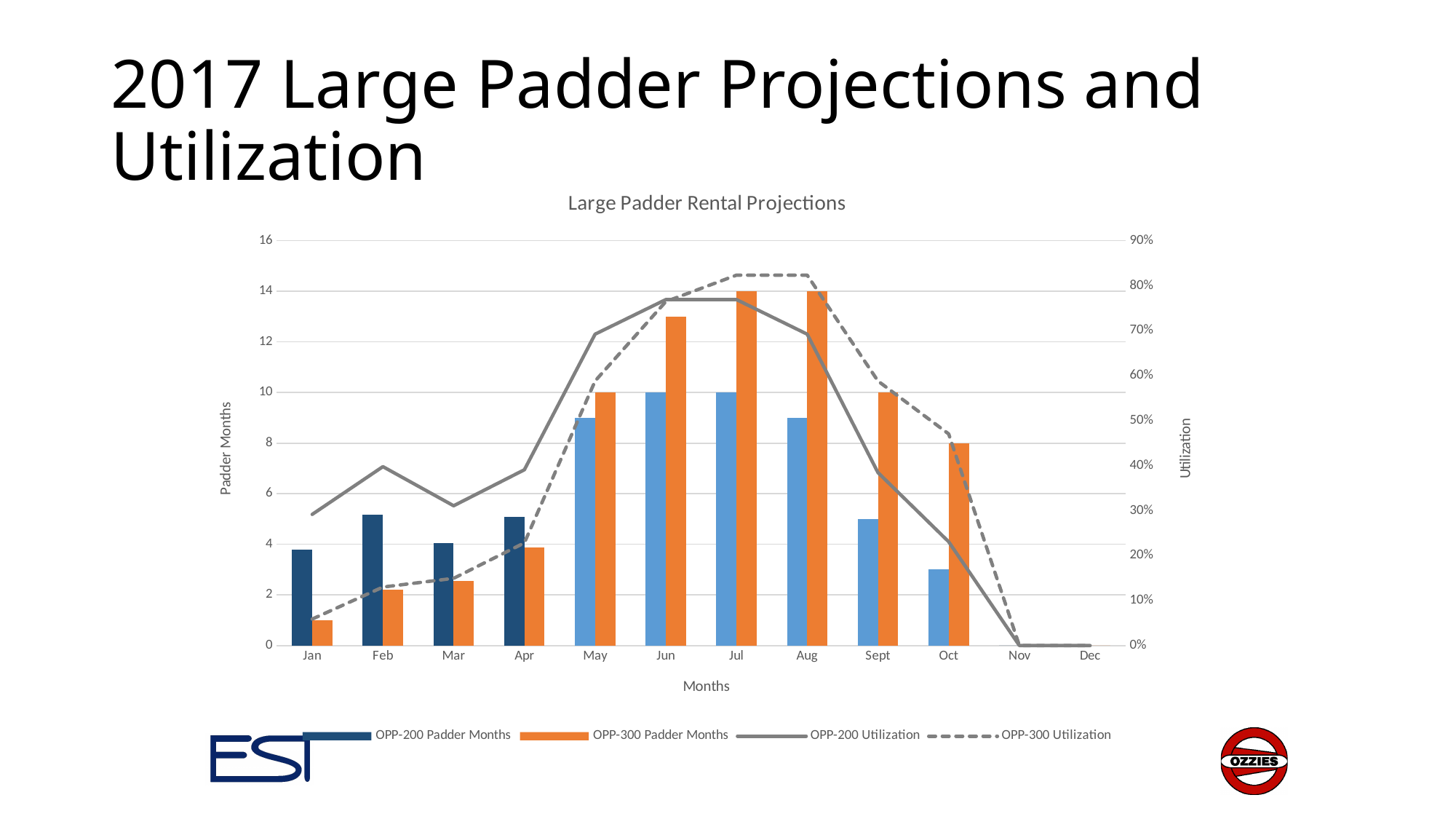
How many series does the chart legend list? 4 What is the OPP-300 Padder Months value for Oct? 8 In Feb, which is larger: OPP-200 Padder Months or OPP-300 Padder Months? OPP-200 Padder Months What is the difference between the OPP-300 Padder Months and OPP-200 Padder Months values in Jul? 4 What kind of chart is shown on the slide? Combination bar and line chart What is the title of the chart? Large Padder Rental Projections What is the OPP-300 Padder Months value for Jul? 14 Is the OPP-200 Utilization value for Jul greater or less than 70%? greater What is the OPP-200 Padder Months value for Jun? 10 Is the OPP-300 Utilization value for Jan greater or less than 10%? less How many months are shown on the x axis of the chart? 12 Does the OPP-200 Utilization line rise or fall from Aug to Nov? fall